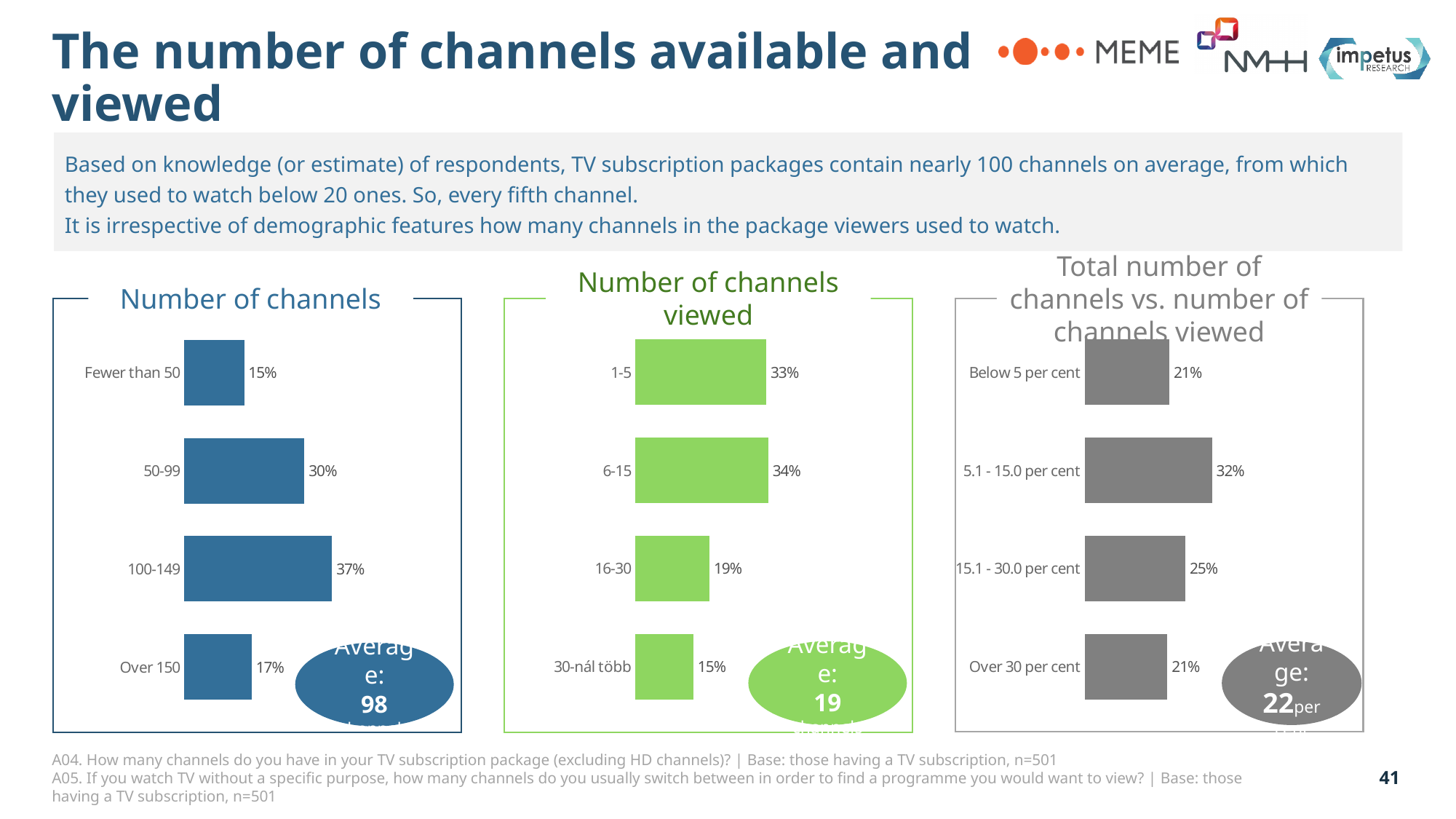
In the 'Total number of channels vs. number of channels viewed' chart, what is the value for 5.1 - 15.0 per cent? 32% In the 'Total number of channels vs. number of channels viewed' chart, what is the difference between the 5.1 - 15.0 per cent and Below 5 per cent categories? 11 percentage points What average is shown in the 'Number of channels viewed' chart? 19 In the 'Number of channels viewed' chart, which category has the highest value? 6-15 In the 'Number of channels viewed' chart, how many categories are shown? 4 In the 'Number of channels' chart, which category has the lowest value? Fewer than 50 What average is shown in the 'Number of channels' chart? 98 In the 'Number of channels viewed' chart, what percentage of respondents view 16-30 channels? 19% In the 'Total number of channels vs. number of channels viewed' chart, which is larger: 15.1 - 30.0 per cent or Over 30 per cent? 15.1 - 30.0 per cent In the 'Number of channels' chart, what is the difference between the 50-99 and Over 150 categories? 13 percentage points What type of chart is the 'Number of channels' chart? Bar chart In the 'Number of channels' chart, what percentage of respondents have 100-149 channels? 37%